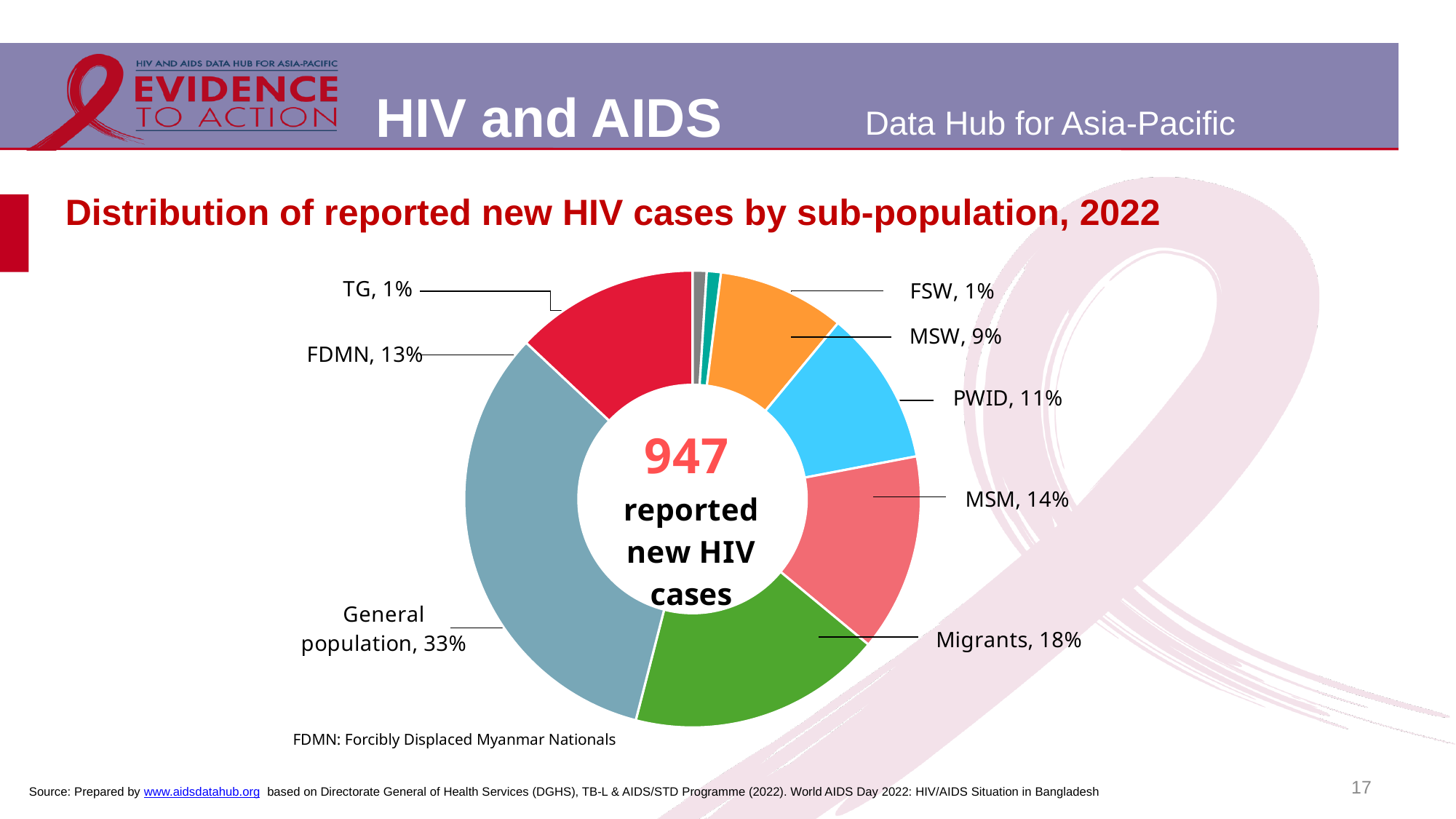
What share of reported new HIV cases is attributed to MSM? 14% What share of reported new HIV cases is attributed to FDMN? 13% What kind of chart is shown on the slide? Pie chart (donut) How many reported new HIV cases are shown in the centre of the chart? 947 What percentage of reported new HIV cases is attributed to PWID? 11% What is the difference in percentage points between the Migrants share and the MSM share? 4 percentage points What share of reported new HIV cases is attributed to the General population? 33% What percentage of reported new HIV cases is attributed to MSW? 9% What does the abbreviation FDMN stand for, according to the note below the chart? Forcibly Displaced Myanmar Nationals Which sub-population has a larger share of reported new HIV cases, PWID or MSW? PWID What percentage of reported new HIV cases is attributed to Migrants? 18% Which sub-population accounts for the largest share of reported new HIV cases? General population